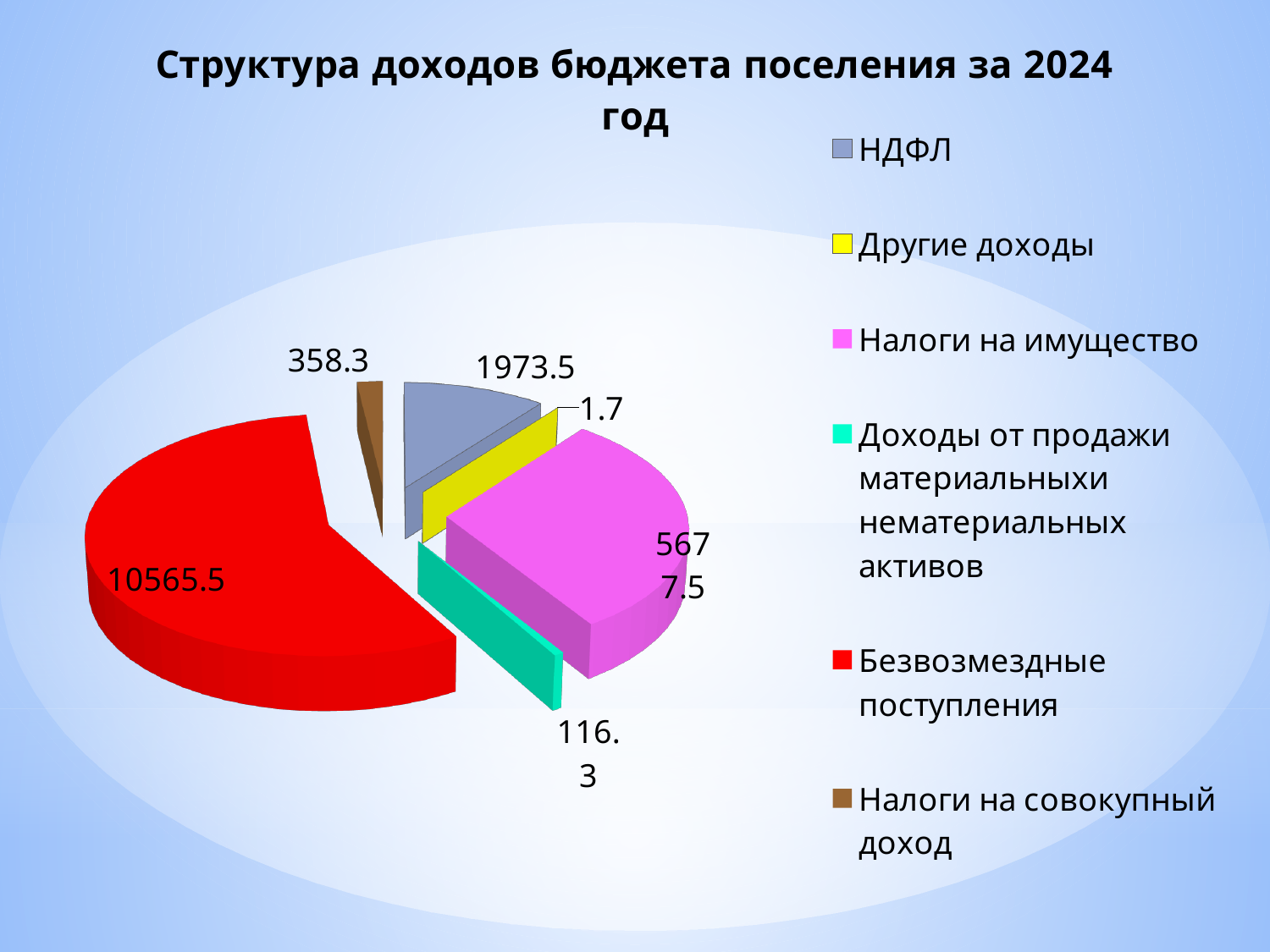
Which is larger, the value for НДФЛ or the value for Налоги на совокупный доход? НДФЛ What is the value for Налоги на имущество? 5677.5 Which category has the smallest slice of the pie? Другие доходы What kind of chart is shown on the slide? pie chart What is the value for Другие доходы? 1.7 How many categories does the legend list? 6 What is the value for НДФЛ? 1973.5 What is the value for Налоги на совокупный доход? 358.3 What is the value for Безвозмездные поступления? 10565.5 What is the title of the chart? Структура доходов бюджета поселения за 2024 год What is the difference between the values for Безвозмездные поступления and Налоги на имущество? 4888 Which category has the largest slice of the pie? Безвозмездные поступления